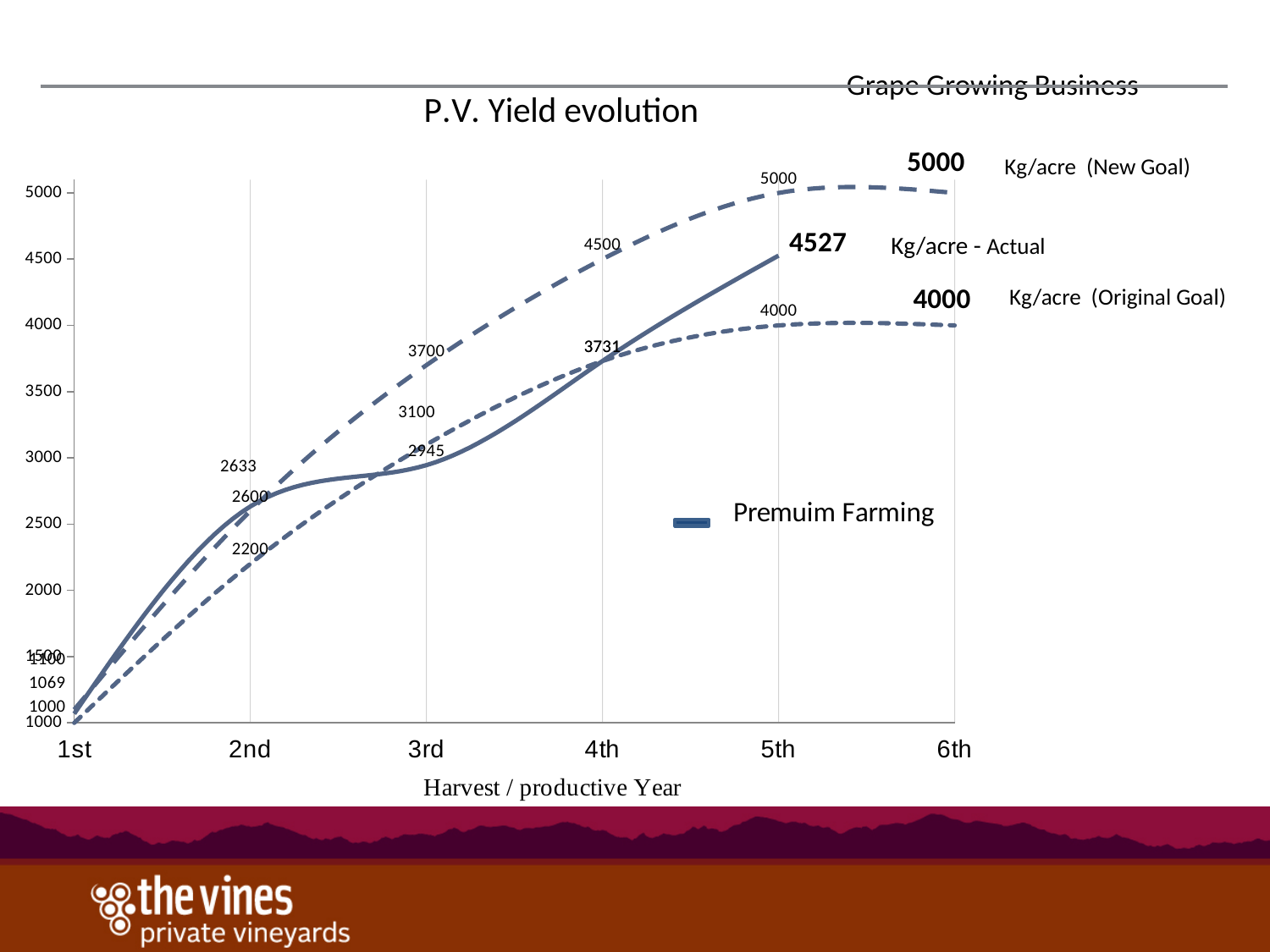
What is the actual yield (Kg/acre - Actual) at the 5th harvest year? 4527 How many harvest years are shown on the x axis? 6 What type of chart is shown on the slide? line chart What is the Original Goal value at the 5th harvest year? 4000 By how much does the actual yield at the 5th harvest year exceed the Original Goal of 4000? 527 Does the actual yield line rise or fall from the 1st to the 5th harvest year? rise What is the New Goal value at the 4th harvest year? 4500 What is the Original Goal value at the 3rd harvest year? 3100 What is the New Goal value at the 5th harvest year? 5000 By how much does the New Goal (5000) exceed the actual yield (4527) at the 5th harvest year? 473 What is the actual yield at the 4th harvest year? 3731 What is the title of the x axis? Harvest / productive Year